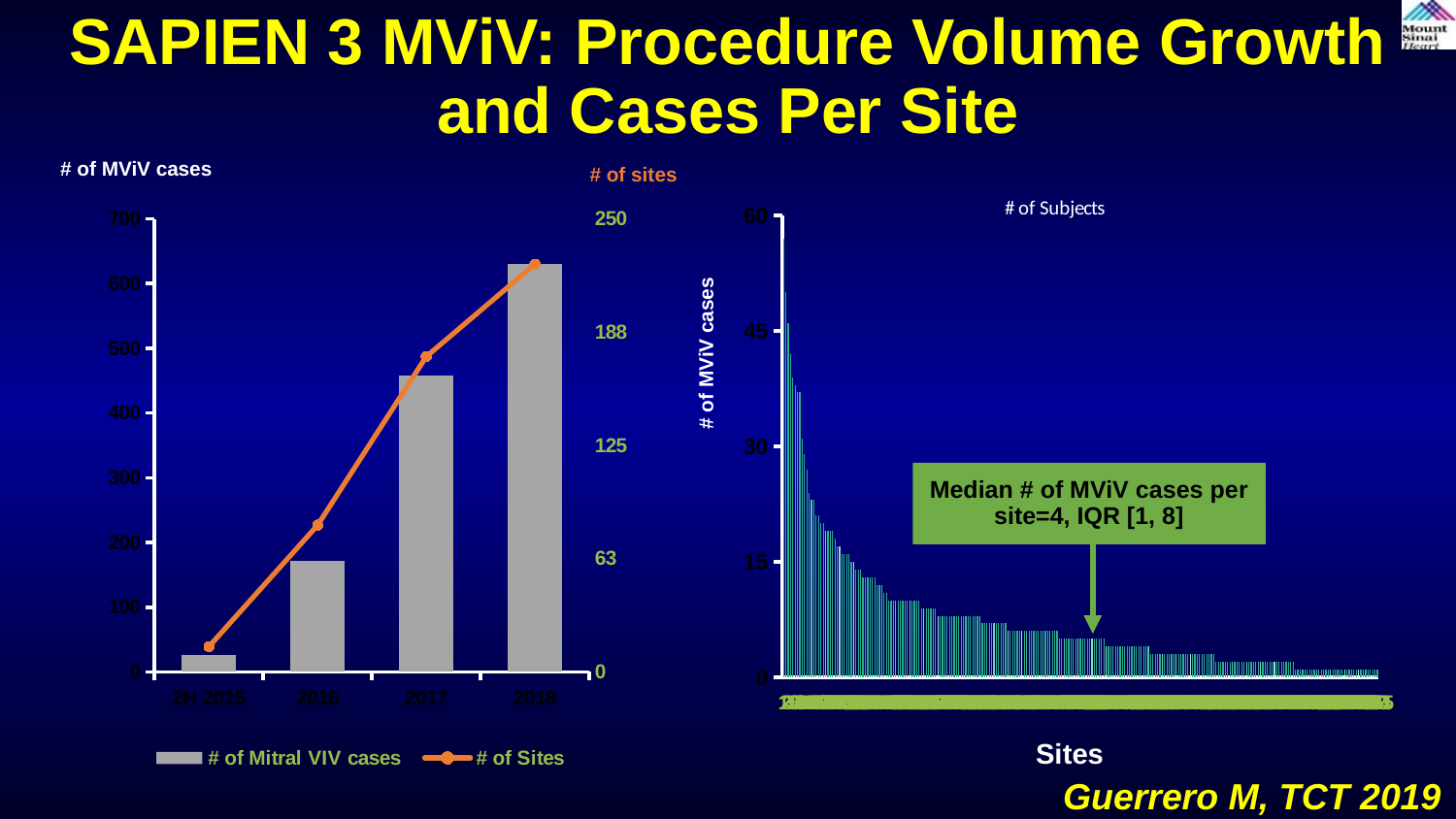
On the left chart, which period has the highest number of Mitral VIV cases? 2018 On the right chart, what is the median number of MViV cases per site stated in the annotation? 4 On the right chart, what is the label of the x axis? Sites On the left chart, which period has more Mitral VIV cases, 2016 or 2017? 2017 On the left chart, what kind of chart is used to show the # of Mitral VIV cases? bar chart On the left chart, do the number of sites rise or fall from 2H 2015 to 2018? rise On the left chart, is the number of Mitral VIV cases in 2018 greater or less than 600? greater On the left chart, is the number of Mitral VIV cases in 2017 greater or less than 400? greater On the left chart, how many series does the legend list? 2 On the left chart, which period has the lowest number of Mitral VIV cases? 2H 2015 On the left chart, is the number of Mitral VIV cases in 2016 greater or less than 200? less On the left chart, how many time periods are shown on the x axis? 4